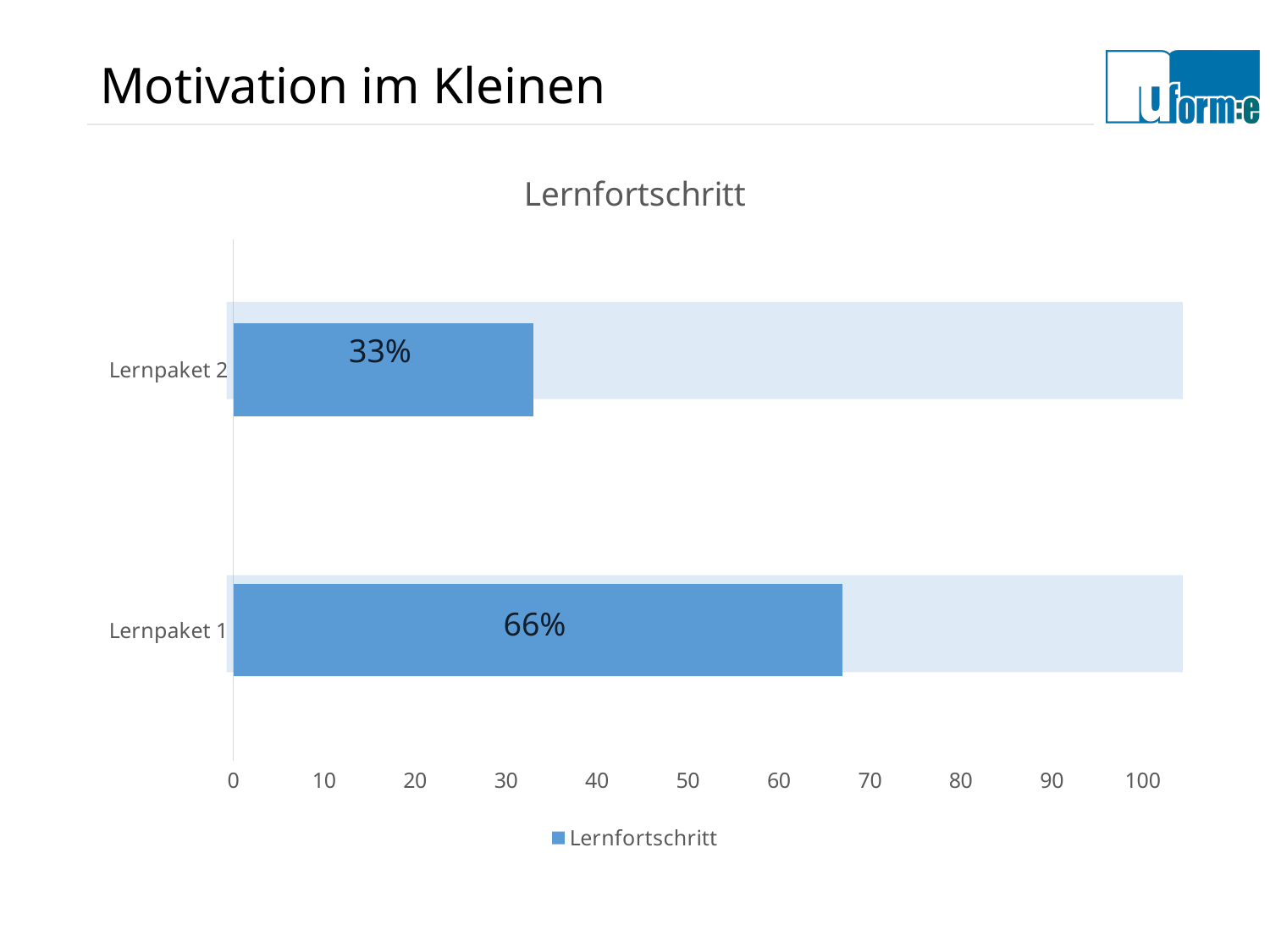
Which is larger, the value for Lernpaket 1 or Lernpaket 2? Lernpaket 1 What kind of chart is shown on the slide? Bar chart Is the value for Lernpaket 2 greater or less than 40? less What is the value for Lernpaket 1? 66% Which category has the highest value? Lernpaket 1 Is the value for Lernpaket 1 greater or less than 50? greater What is the difference between the values for Lernpaket 1 and Lernpaket 2? 33% How many series does the legend list? 1 What is the value for Lernpaket 2? 33% How many categories are shown in the chart? 2 Which category has the lowest value? Lernpaket 2 What is the title of the chart? Lernfortschritt